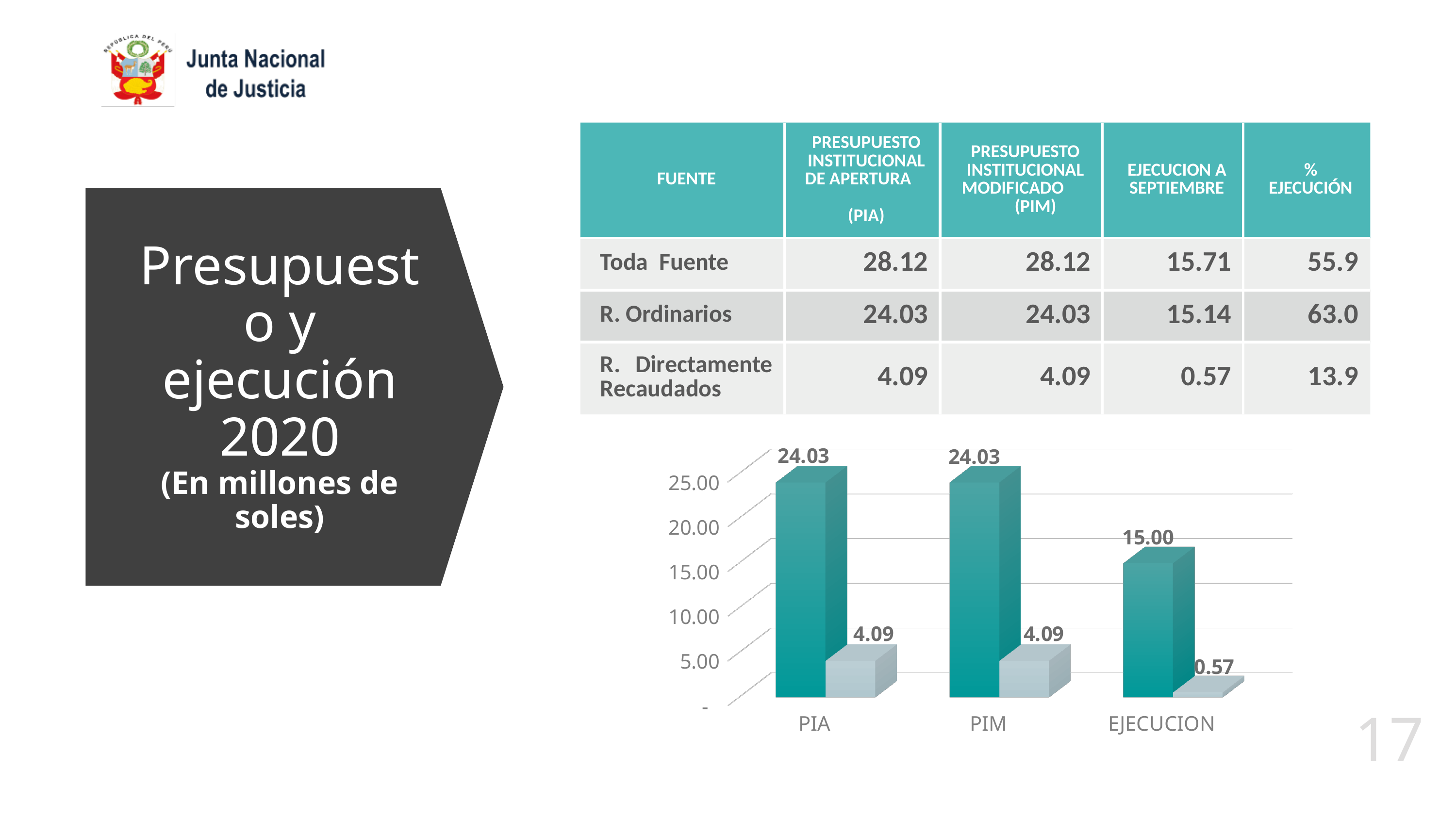
In the bar chart, what is the difference between the teal bar for PIA and the teal bar for EJECUCION? 9.03 How many categories are shown on the x axis of the bar chart? 3 In the bar chart, what is the value of the light grey bar for EJECUCION? 0.57 What is the label of the last category on the x axis of the bar chart? EJECUCION In the bar chart, what is the difference between the light grey bar for PIM and the light grey bar for EJECUCION? 3.52 In the bar chart, what is the value of the teal bar for PIA? 24.03 What kind of chart is shown on the slide? bar chart In the bar chart, what is the value of the light grey bar for PIM? 4.09 In the bar chart, what is the value of the teal bar for EJECUCION? 15.00 Do the teal bars rise or fall from PIM to EJECUCION in the bar chart? fall In the bar chart, which category has the lowest teal bar? EJECUCION In the bar chart, which is larger: the teal bar for EJECUCION or the light grey bar for PIA? the teal bar for EJECUCION